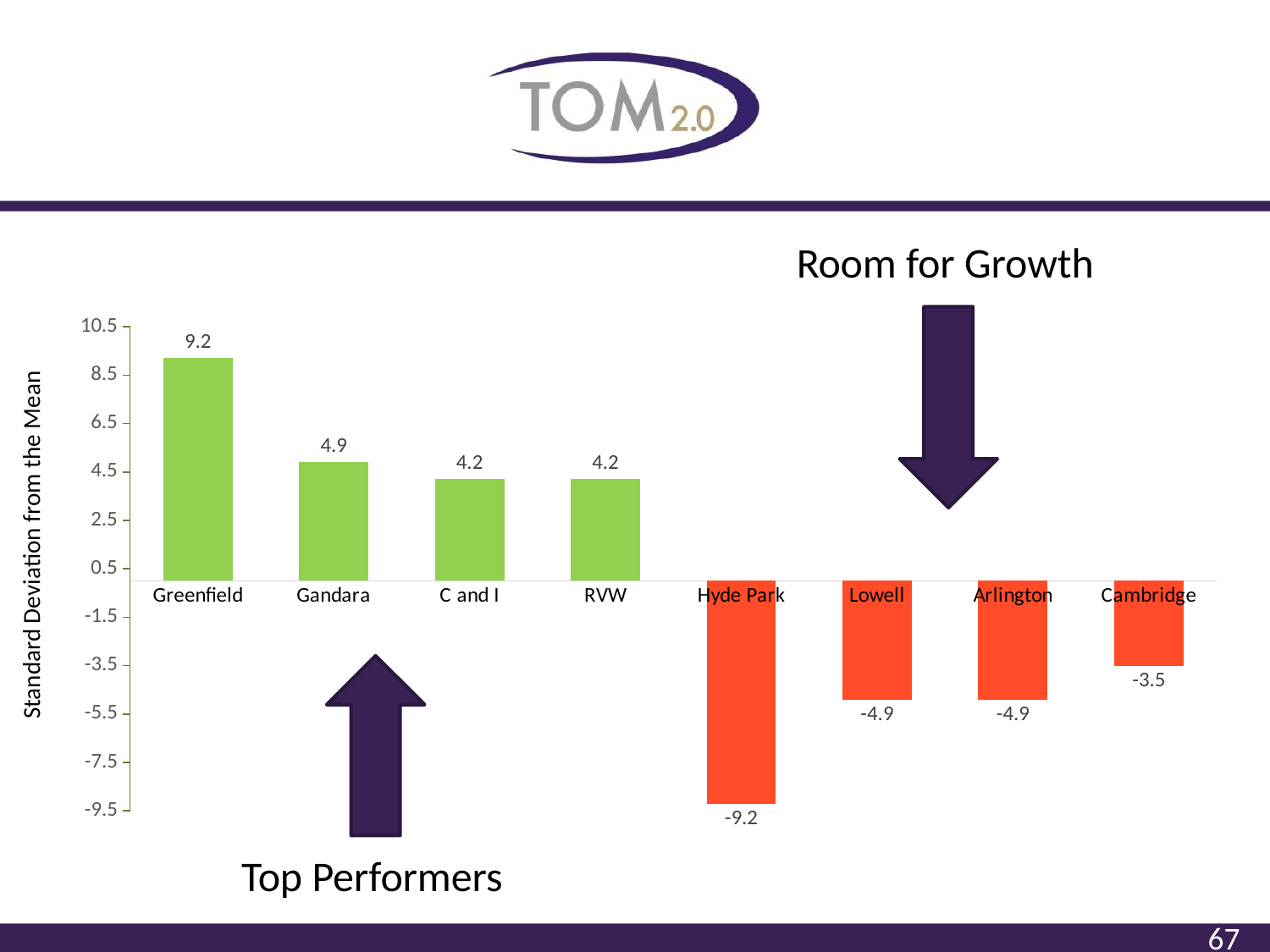
What is the value for Greenfield? 9.2 What is the label of the vertical axis? Standard Deviation from the Mean What is the value for Cambridge? -3.5 What colour are the bars with negative values? Red Which category has the lowest value? Hyde Park Which category has the highest value? Greenfield What kind of chart is shown on the slide? Bar chart What is the difference between the values for Greenfield and Gandara? 4.3 Which is larger, the value for Lowell or the value for Cambridge? Cambridge How many categories are shown on the x axis? 8 What is the value for Gandara? 4.9 What is the value for Hyde Park? -9.2